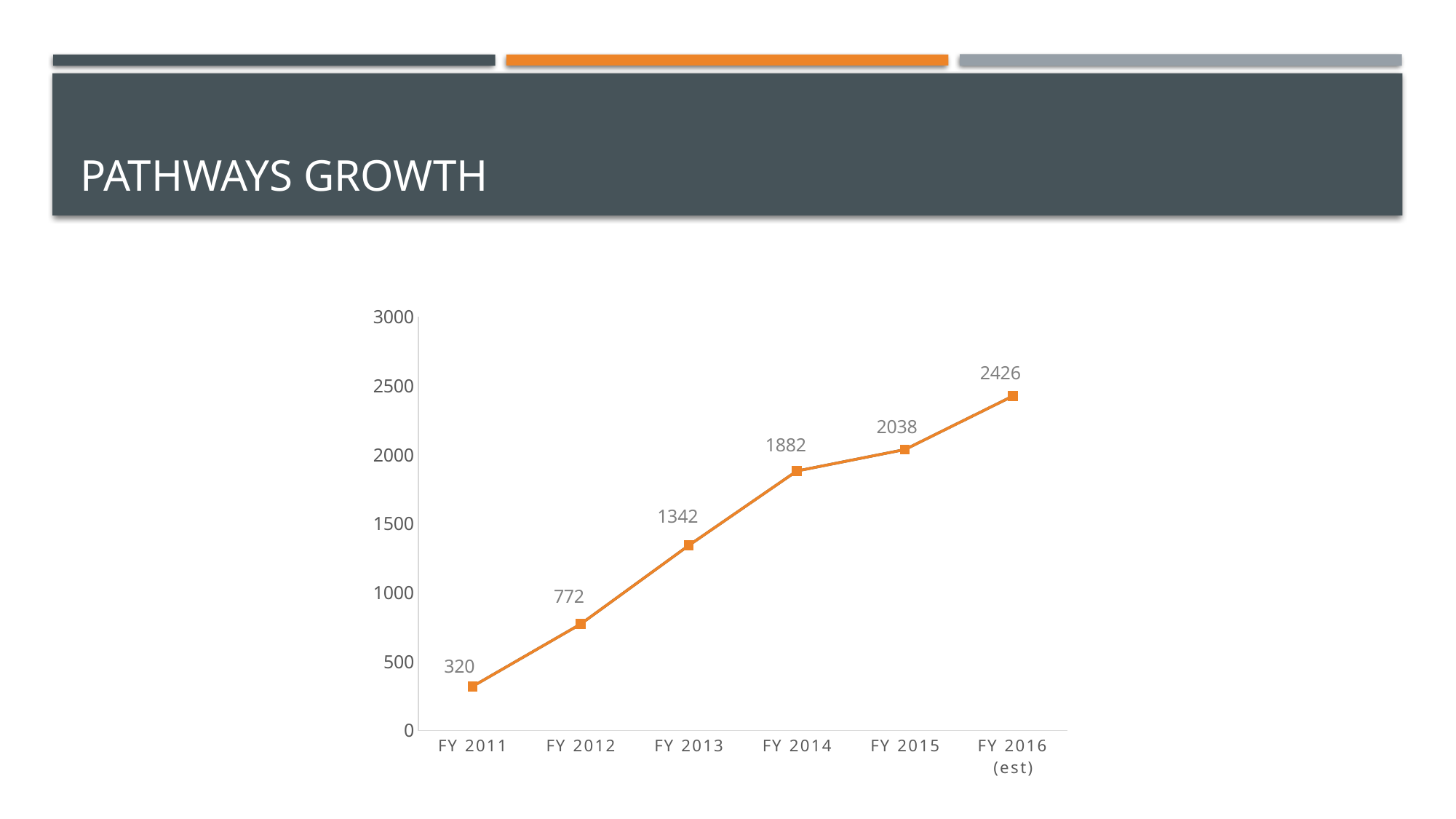
What kind of chart is shown on the slide? line chart What is the difference between the FY 2015 and FY 2014 values? 156 What is the value for FY 2011? 320 Do the values rise or fall from FY 2011 to FY 2016 (est)? rise Which fiscal year has the lowest value? FY 2011 Which fiscal year has the highest value? FY 2016 (est) What is the difference between the FY 2013 and FY 2012 values? 570 Which is larger, the value for FY 2014 or the value for FY 2012? FY 2014 What is the value for FY 2013? 1342 How many fiscal years are plotted on the chart? 6 Is the value for FY 2015 greater or less than 2000? greater What is the value for FY 2016 (est)? 2426